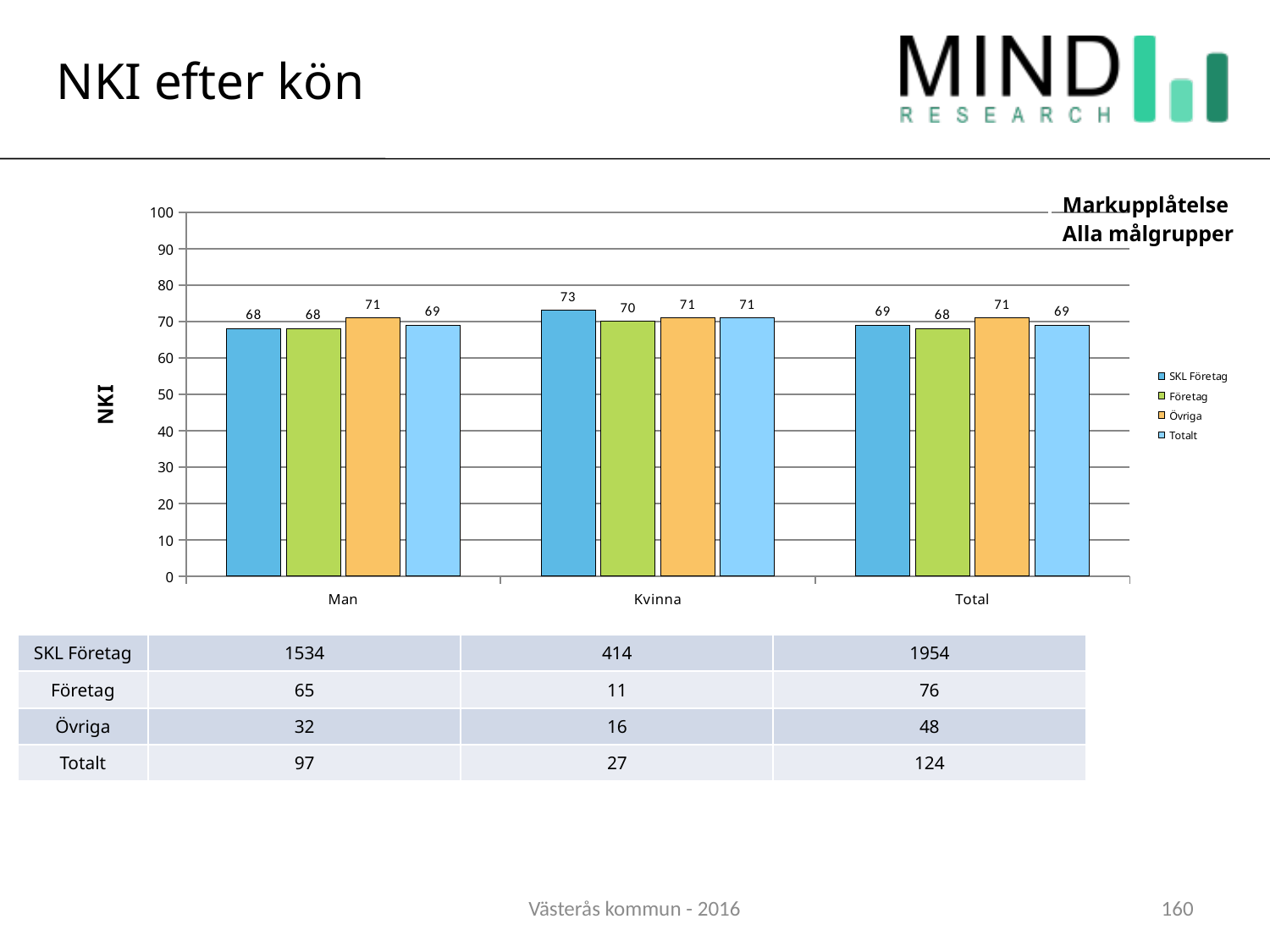
What is the NKI value for Övriga in the Man category? 71 What is the label on the vertical axis of the chart? NKI Is the SKL Företag value for Kvinna greater or less than 80? less How many series does the legend list? 4 How many categories are shown on the x axis? 3 What kind of chart is shown on the slide? bar chart What is the NKI value for SKL Företag in the Kvinna category? 73 What is the difference between the SKL Företag value for Kvinna and the SKL Företag value for Man? 5 What is the NKI value for Totalt in the Total category? 69 Which series has the highest NKI value in the Kvinna category? SKL Företag What is the NKI value for Företag in the Kvinna category? 70 Which is larger: the Övriga value for Man or the Företag value for Man? Övriga